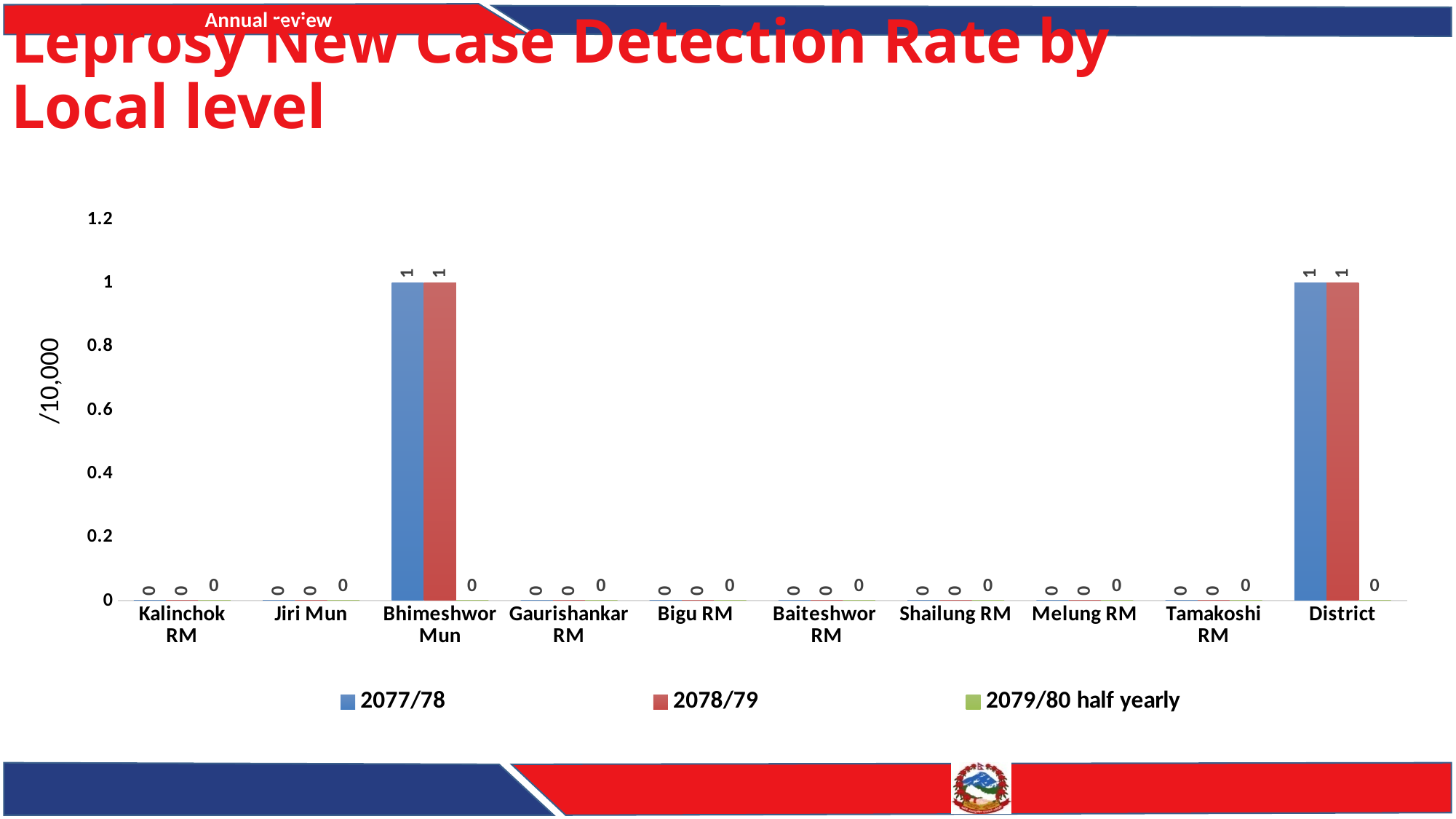
What is the value for District in 2078/79? 1 What is the value for Bhimeshwor Mun in 2077/78? 1 How many series does the legend list? 3 What is the y-axis label of the chart? /10,000 What is the value for Jiri Mun in 2077/78? 0 Which category has the highest value in 2078/79 among the local levels (excluding District)? Bhimeshwor Mun What is the value for Kalinchok RM in 2079/80 half yearly? 0 What kind of chart is shown on the slide? bar chart Which is larger: the 2078/79 value for Bhimeshwor Mun or the 2078/79 value for Shailung RM? Bhimeshwor Mun Which legend entry is shown in green? 2079/80 half yearly What is the difference between the 2077/78 value for Bhimeshwor Mun and the 2077/78 value for Bigu RM? 1 How many local-level categories are shown on the x axis? 10